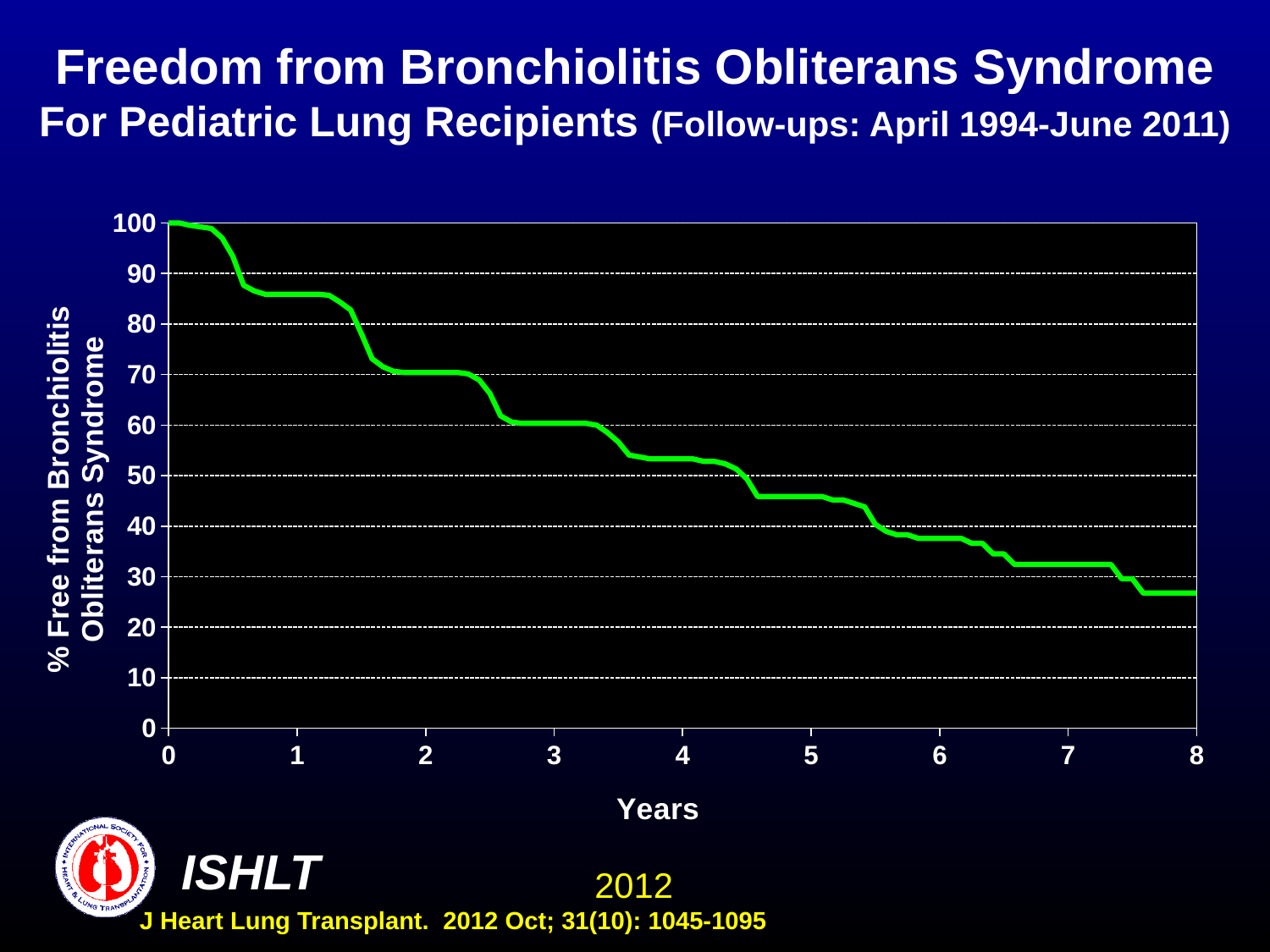
Is the value at year 4 greater or less than 60? less Is the value at year 2 greater or less than 80? less Is the value at year 5 greater or less than 50? less Which is larger, the value at year 1 or the value at year 7? year 1 What is the value of the curve at year 0? 100 Does the percentage free from bronchiolitis obliterans syndrome rise or fall as years increase? fall What is the label of the x axis? Years What kind of chart is shown on the slide? line chart How many lines are plotted on the chart? 1